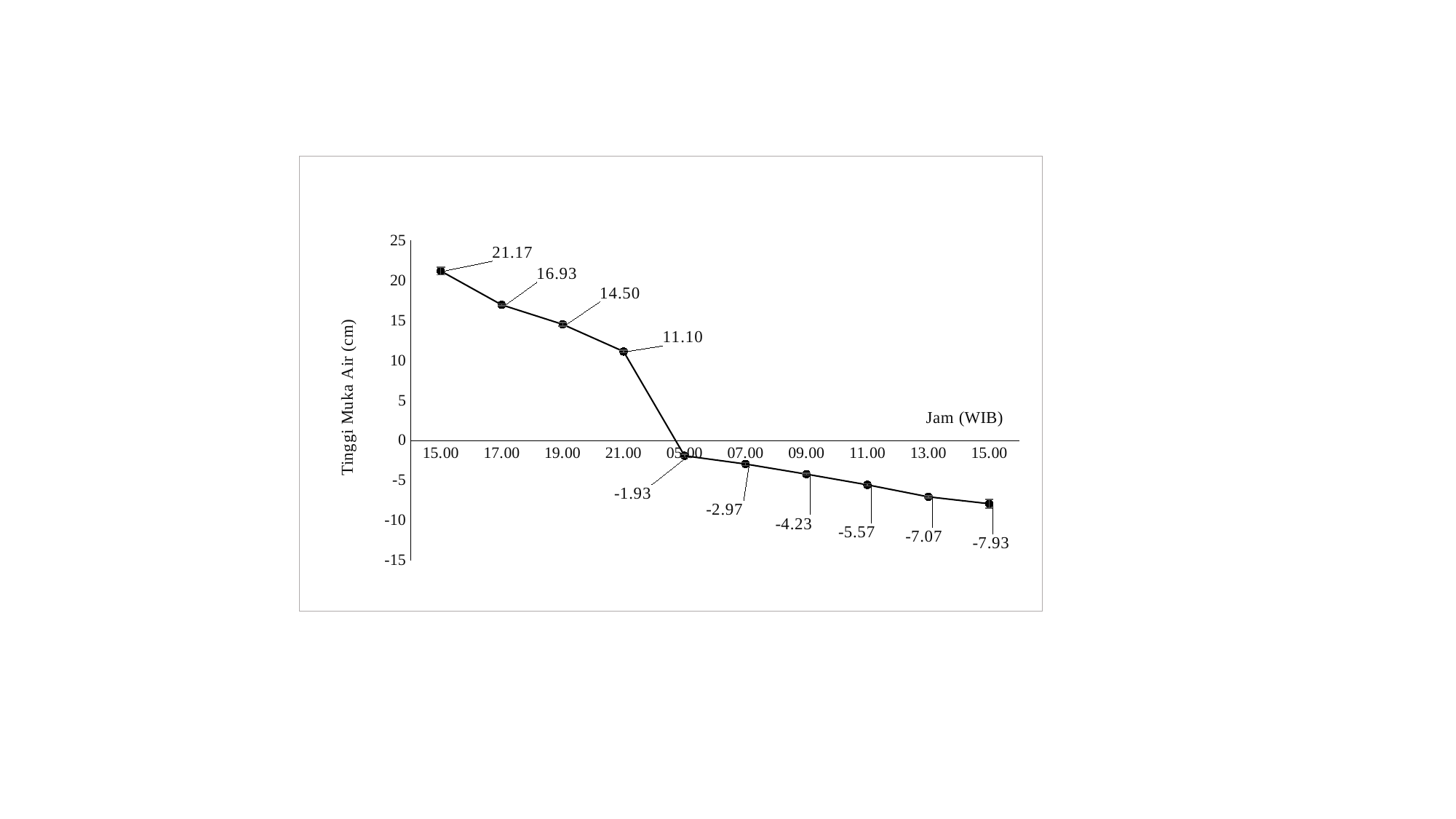
At which time is the water level lowest? 15.00 (the last point) What type of chart is shown on the slide? line chart What is the water level at the last 15.00 WIB point on the right end of the x axis? -7.93 What is the label of the y axis? Tinggi Muka Air (cm) How many data points are plotted on the line? 10 What is the difference between the water level at 17.00 and at 21.00 WIB? 5.83 Do the values rise or fall along the x axis from left to right? fall What is the water level (Tinggi Muka Air) at 19.00 WIB? 14.50 At which time is the water level highest? 15.00 (the first point) What is the water level at 09.00 WIB? -4.23 What is the water level at 21.00 WIB? 11.10 Which is larger, the water level at 05.00 or at 07.00 WIB? 05.00